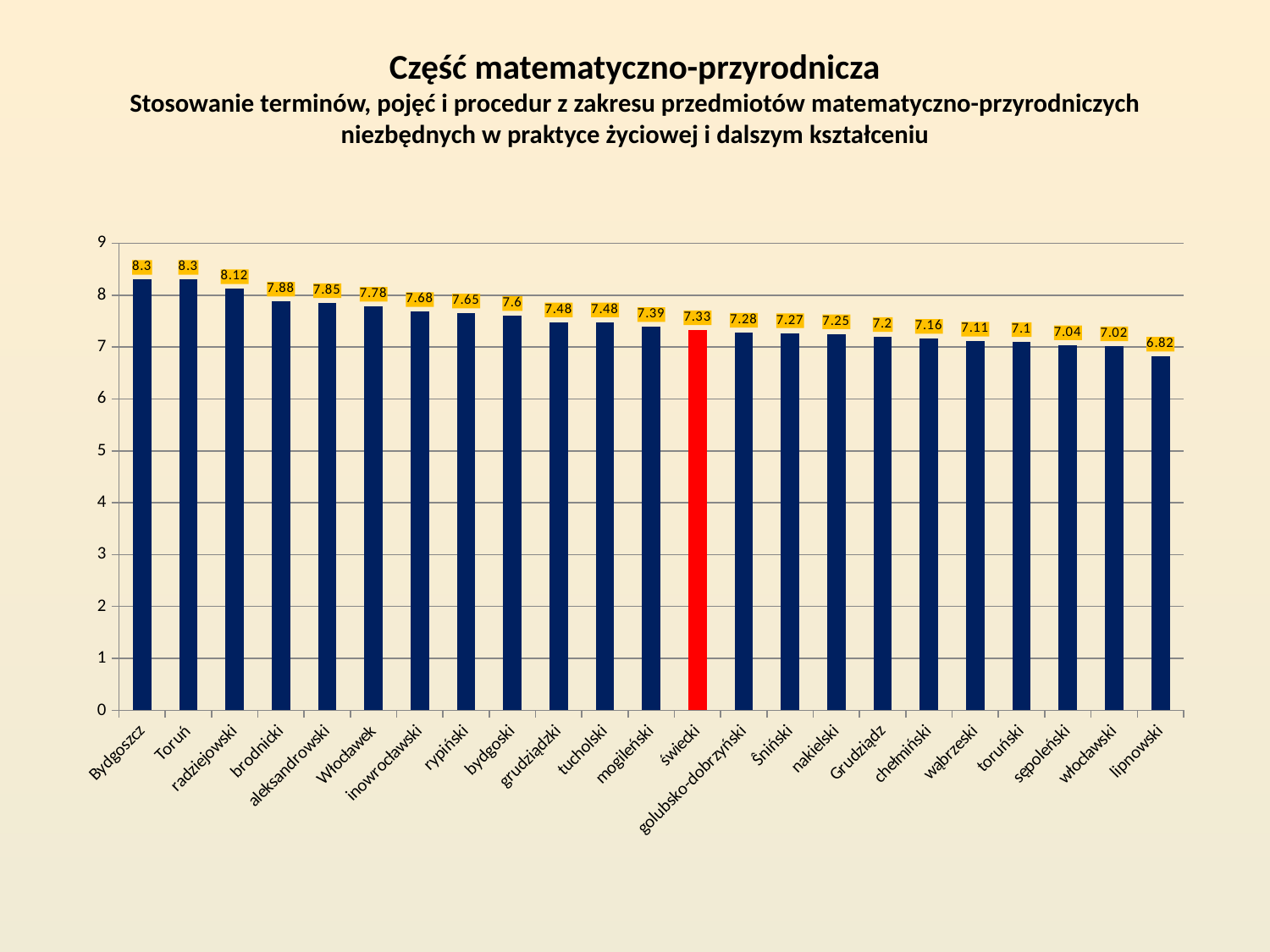
Is the value for nakielski greater or less than 7? greater What is the difference between the values for Bydgoszcz and lipnowski? 1.48 How many categories are shown on the x axis? 23 Which category has the lowest value? lipnowski What is the value for radziejowski? 8.12 What is the value for lipnowski? 6.82 Which category's bar is coloured red instead of dark blue? świecki What is the value for świecki? 7.33 Which is larger, the value for Włocławek or the value for włocławski? Włocławek What is the difference between the values for brodnicki and Grudziądz? 0.68 Do the values rise or fall from left to right along the x axis? fall What kind of chart is shown on the slide? bar chart